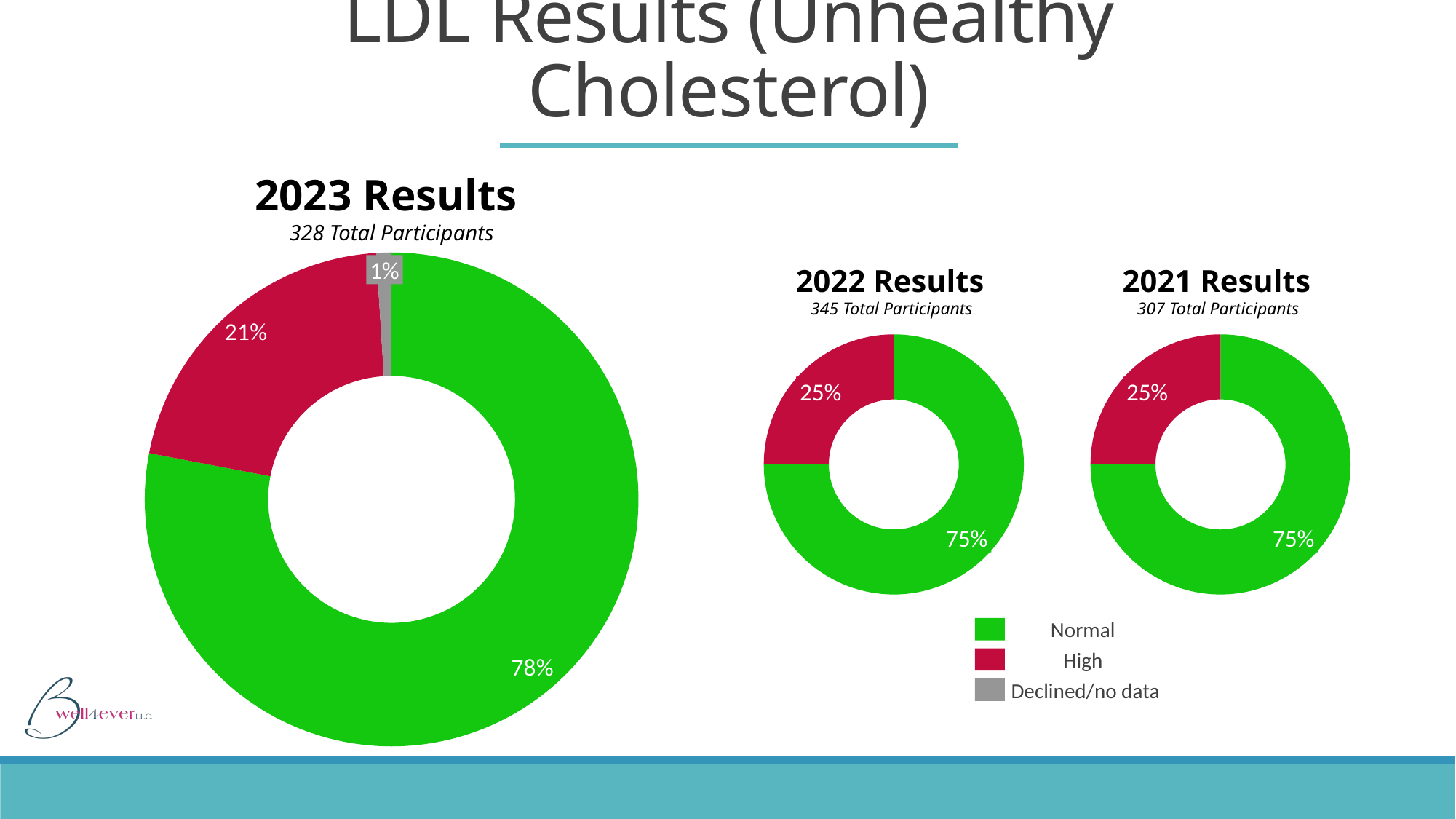
How many total participants are reported for the 2022 Results chart? 345 In the 2023 Results chart, which category has the smallest share? Declined/no data In the 2021 Results chart, what percentage of participants had Normal LDL? 75% In the 2022 Results chart, what percentage of participants had High LDL? 25% In the 2023 Results chart, which category has the largest share? Normal How many categories does the legend list? 3 Is the High share larger in the 2023 Results chart or the 2022 Results chart? 2022 Results In the 2023 Results chart, what is the difference between the Normal and High percentages? 57% In the 2023 Results chart, what percentage is shown for Declined/no data? 1% In the 2023 Results chart, what percentage of participants had High LDL? 21% What kind of chart is used for the 2023 Results? Doughnut chart In the 2023 Results chart, what percentage of participants had Normal LDL? 78%